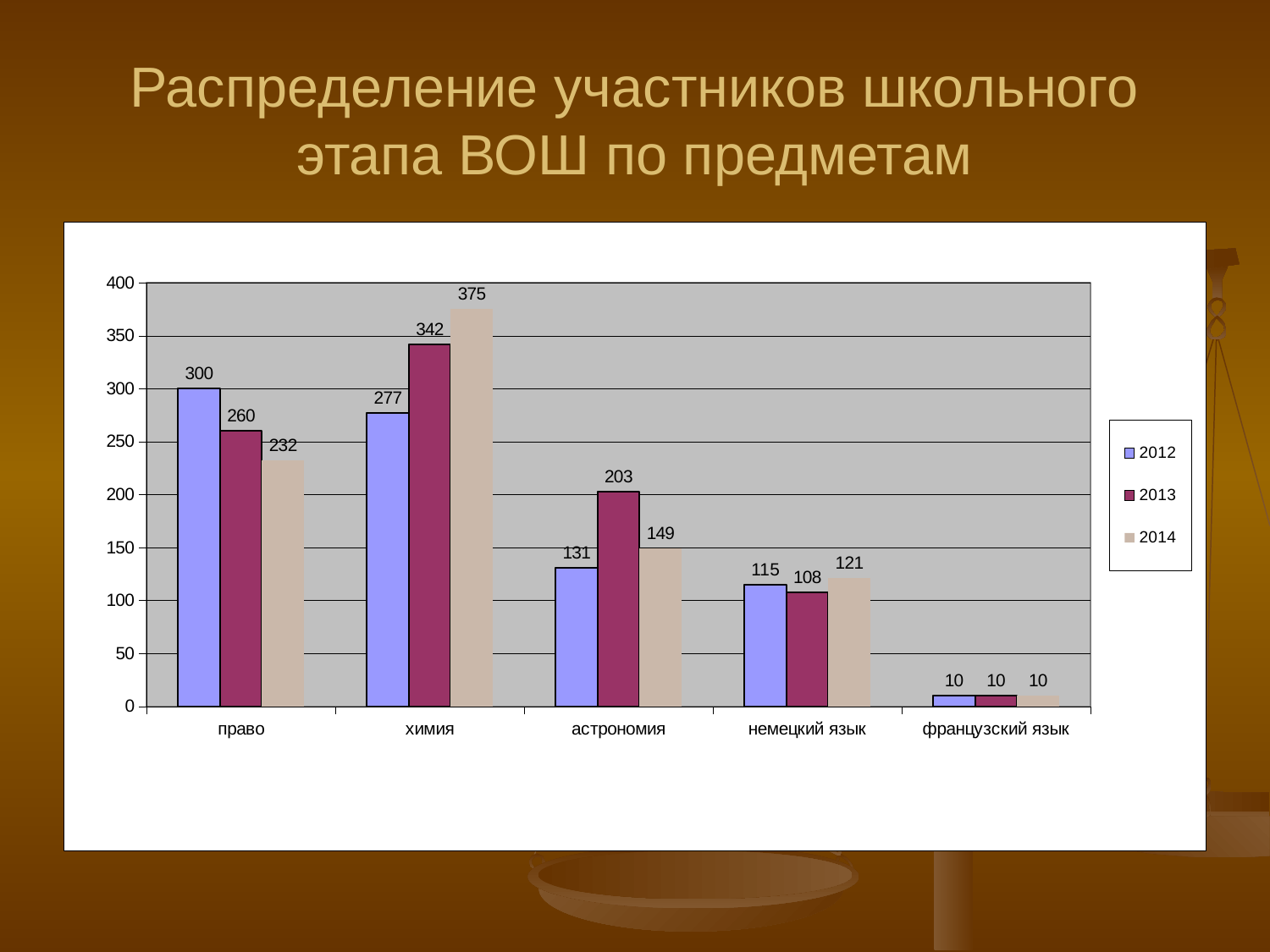
What is the value for немецкий язык in 2013? 108 Which category has the highest value in the 2013 series? химия What is the difference between the 2012 and 2014 values for право? 68 How many series does the legend list? 3 What is the value for право in 2012? 300 Do the values for право rise or fall from 2012 to 2014? fall What is the value for химия in 2014? 375 Which is larger for астрономия: the 2013 value or the 2014 value? 2013 How many categories are shown on the x axis? 5 What kind of chart is shown on the slide? bar chart Which category has the lowest value in the 2012 series? французский язык What is the difference between the 2014 and 2012 values for химия? 98